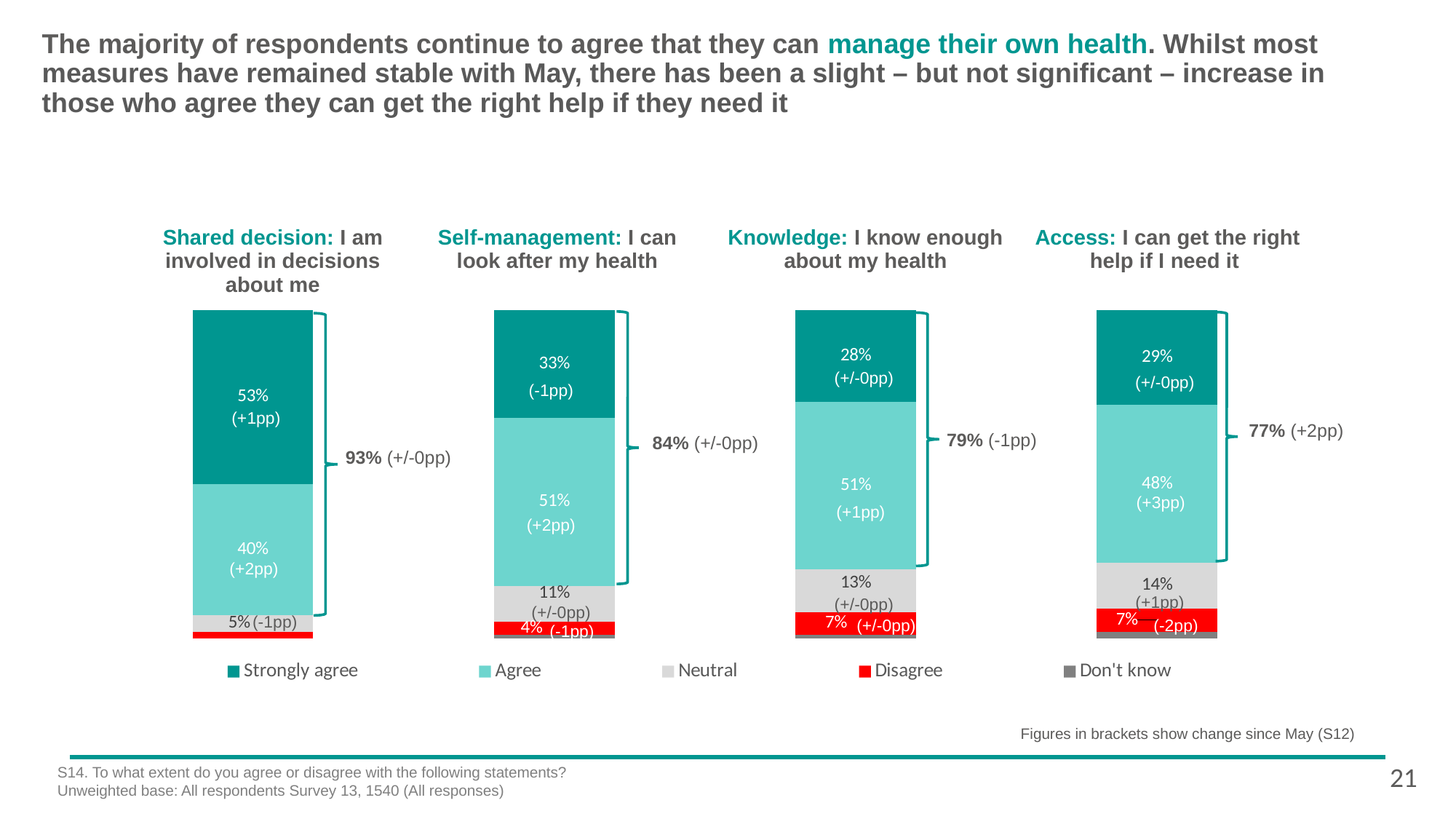
In the 'Access: I can get the right help if I need it' chart, what percentage of respondents are neutral? 14% Which of the four statements has the highest combined agree figure shown next to its bar? Shared decision: I am involved in decisions about me In the 'Self-management: I can look after my health' chart, what percentage of respondents agree? 51% Is the strongly agree percentage larger in the 'Self-management: I can look after my health' chart or the 'Knowledge: I know enough about my health' chart? Self-management: I can look after my health In the 'Knowledge: I know enough about my health' chart, what percentage of respondents disagree? 7% Which of the four statements has the lowest combined agree figure shown next to its bar? Access: I can get the right help if I need it What is the combined 'strongly agree' plus 'agree' figure shown for the 'Access: I can get the right help if I need it' chart? 77% In the 'Shared decision: I am involved in decisions about me' chart, what percentage of respondents strongly agree? 53% How many series does the legend list? 5 What change since May is shown in brackets for the agree segment of the 'Access: I can get the right help if I need it' chart? +3pp What kind of chart is used to show the responses on this slide? Stacked bar chart In the 'Shared decision: I am involved in decisions about me' chart, what is the difference between the strongly agree and agree percentages? 13%